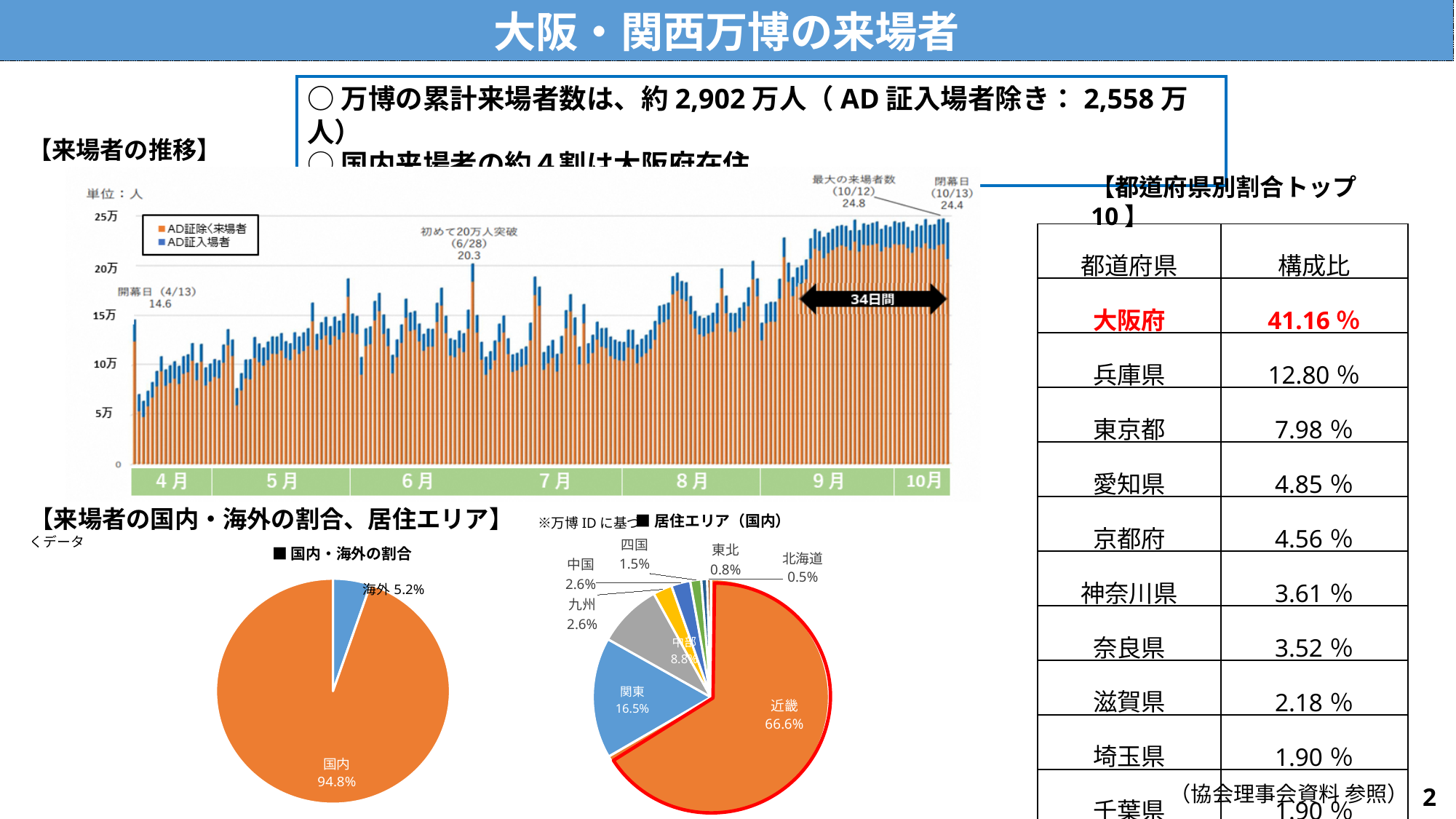
In the 居住エリア（国内） pie chart, how many percentage points larger is 近畿 than 関東? 50.1 In the 居住エリア（国内） pie chart, what share is labelled for 近畿? 66.6% In the 国内・海外の割合 pie chart, what share is labelled for 国内? 94.8% What kind of chart is the 来場者の推移 chart? bar chart In the 居住エリア（国内） pie chart, what share is labelled for 関東? 16.5% In the 国内・海外の割合 pie chart, what share is labelled for 海外? 5.2% In the 居住エリア（国内） pie chart, which region has the largest slice? 近畿 In the 居住エリア（国内） pie chart, which region has the smallest slice? 北海道 In the 来場者の推移 chart, what value is labelled for 最大の来場者数 on 10/12? 24.8 In the 居住エリア（国内） pie chart, how many regions (slices) are shown? 8 In the 来場者の推移 chart, how many series does the legend list? 2 In the 居住エリア（国内） pie chart, which is larger, 中部 or 九州? 中部